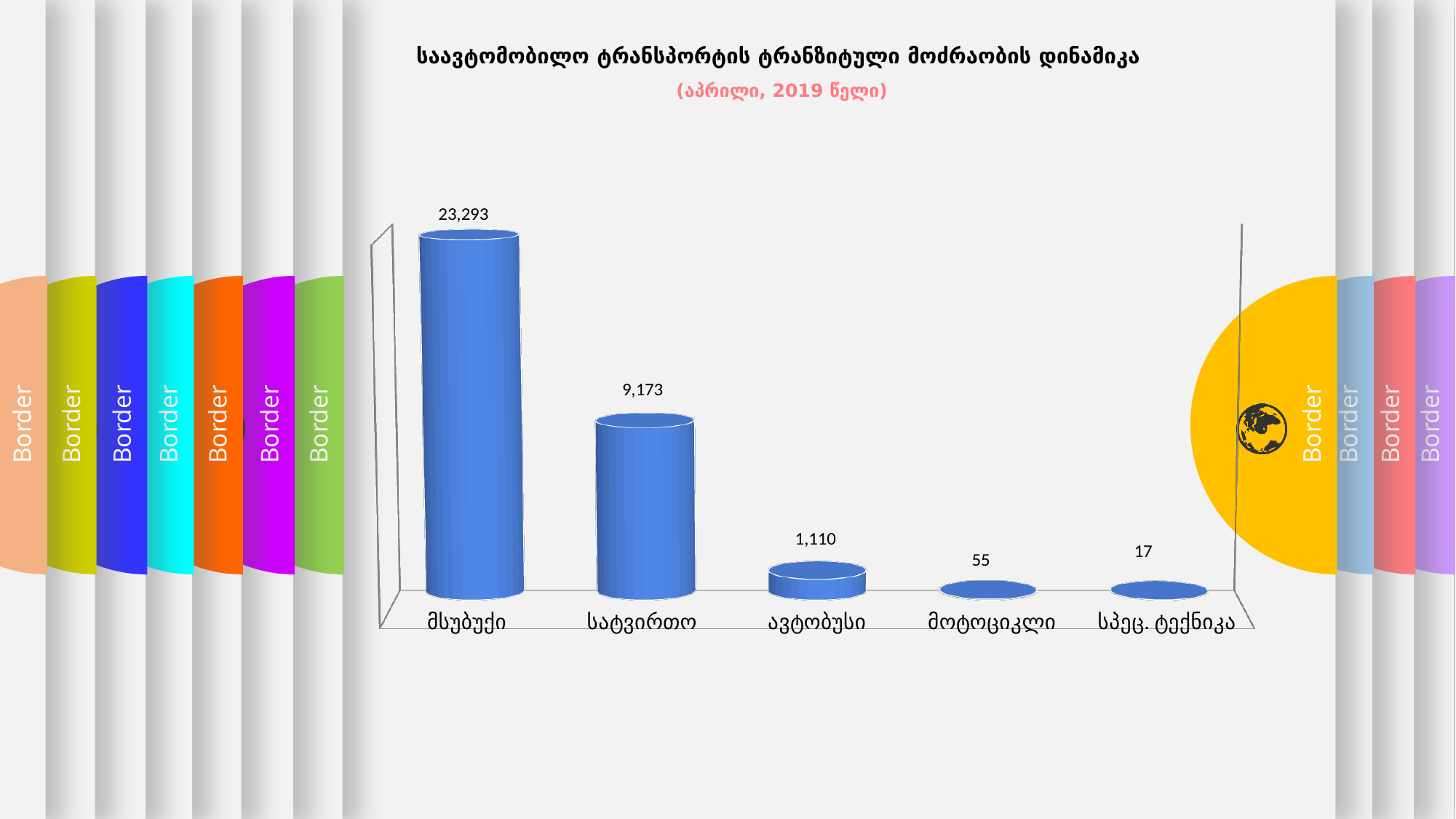
What is the value for ავტობუსი? 1,110 What is the value for მსუბუქი? 23,293 What is the difference between the values for მსუბუქი and სატვირთო? 14,120 Which category has the lowest value? სპეც. ტექნიკა Which category has the highest value? მსუბუქი What is the value for მოტოციკლი? 55 What kind of chart is shown on the slide? Bar chart How many categories are shown in the chart? 5 What period is given in the chart's subtitle? აპრილი, 2019 წელი What is the value for სატვირთო? 9,173 What is the value for სპეც. ტექნიკა? 17 Which is larger, the value for ავტობუსი or the value for მოტოციკლი? ავტობუსი